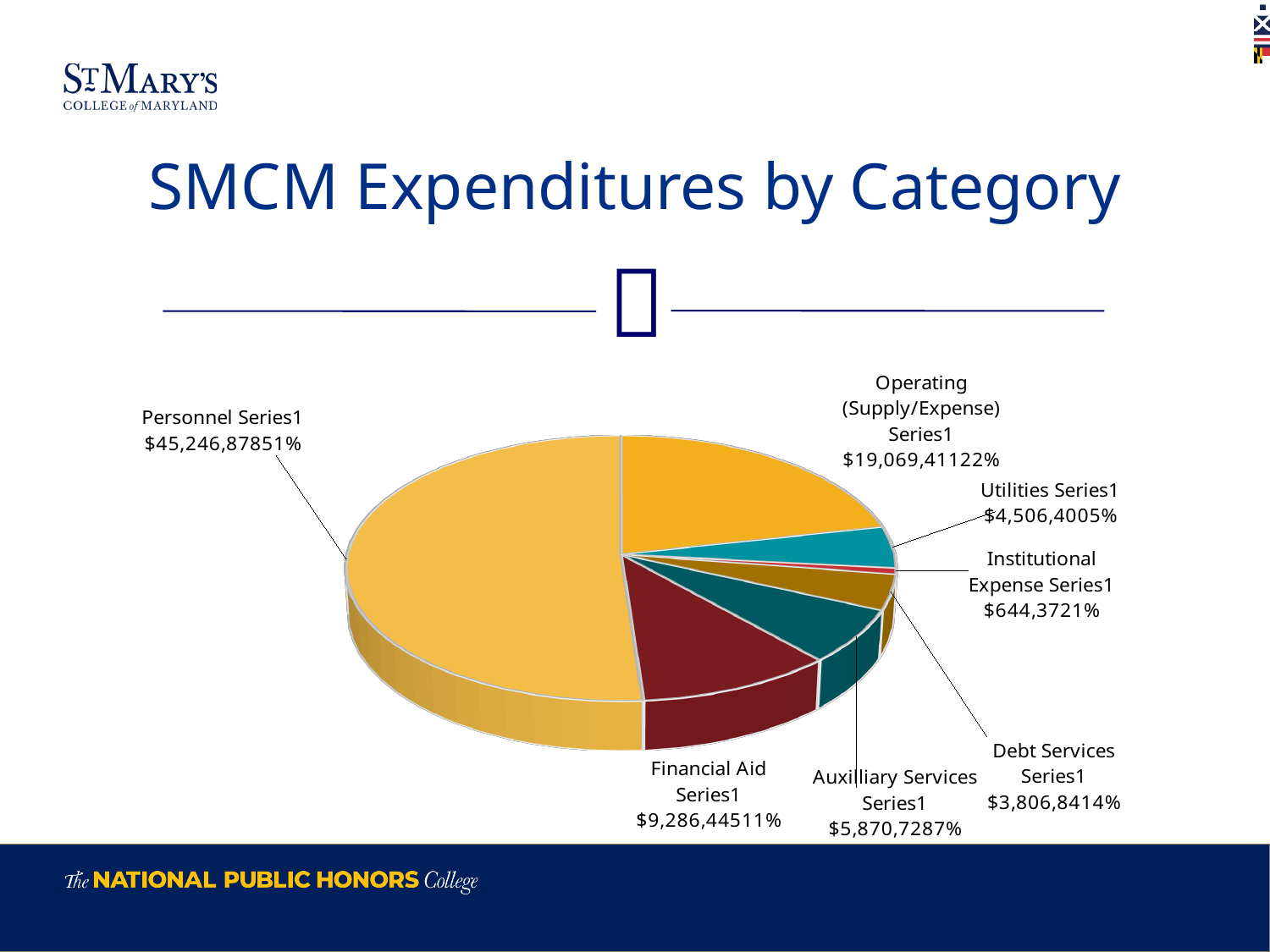
What value label is printed for the Debt Services slice? $3,806,8414% What value label is printed for the Financial Aid slice? $9,286,44511% Which slice is larger, Operating (Supply/Expense) or Utilities? Operating (Supply/Expense) What value label is printed for the Utilities slice? $4,506,4005% What value label is printed for the Institutional Expense slice? $644,3721% Which slice is larger, Financial Aid or Auxilliary Services? Financial Aid What is the title of the chart on the slide? SMCM Expenditures by Category Which category has the smallest slice of the pie? Institutional Expense How many slices does the pie chart have? 7 Which category is shown in the dark red slice? Financial Aid What kind of chart is shown on the slide? pie chart Which category has the largest slice of the pie? Personnel